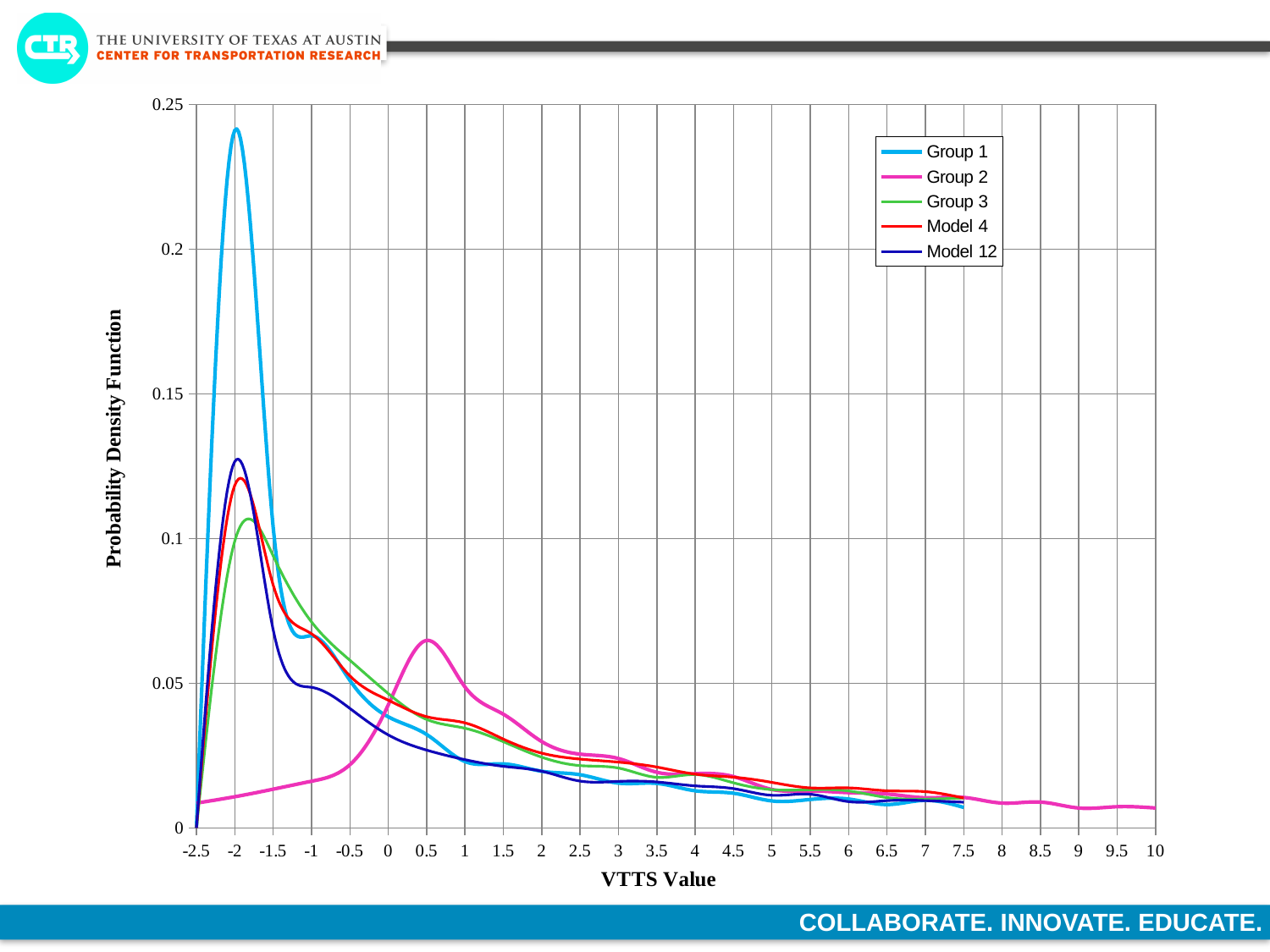
Which series reaches the highest peak value? Group 1 Is the peak value of Model 12 greater or less than 0.1? greater Which is larger at a VTTS Value of 0.5: Group 2 or Group 1? Group 2 Is the peak value of Group 1 greater or less than 0.2? greater What is the title of the y axis? Probability Density Function Which is larger at its peak: Group 1 or Model 12? Group 1 How many series does the legend list? 5 Does the Group 2 line rise or fall from a VTTS Value of 0.5 to 10? fall What kind of chart is shown on the slide? line chart Is the peak value of Group 3 greater or less than 0.15? less What is the title of the x axis? VTTS Value